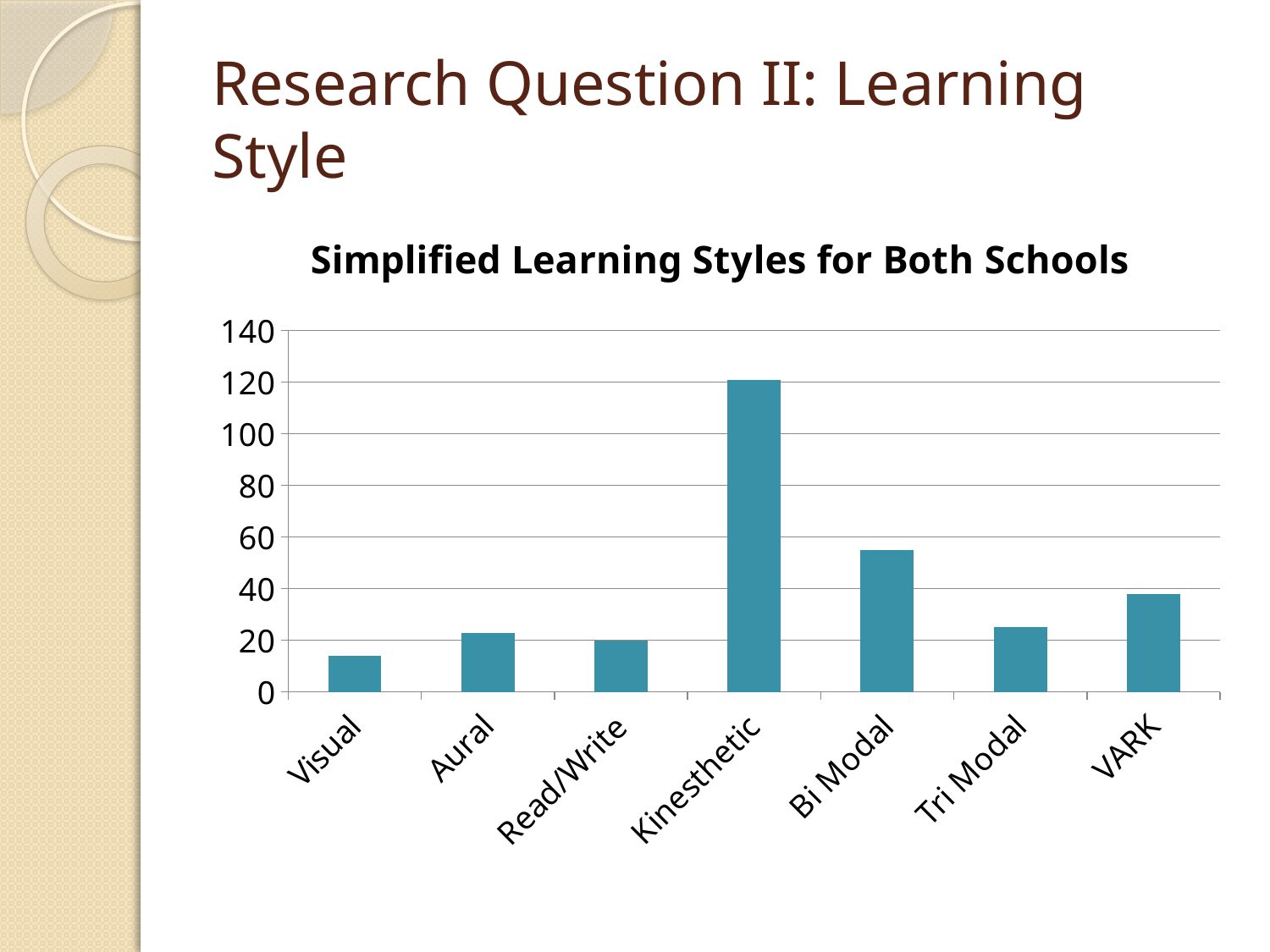
Which is larger, the value for Bi Modal or the value for VARK? Bi Modal Which is larger, the value for Aural or the value for Visual? Aural Which is larger, the value for Kinesthetic or the value for Bi Modal? Kinesthetic What is the title of the chart? Simplified Learning Styles for Both Schools Is the value for Kinesthetic greater or less than 100? greater Which learning style has the highest value? Kinesthetic Is the value for VARK greater or less than 20? greater Is the value for Bi Modal greater or less than 40? greater Which learning style has the lowest value? Visual How many learning style categories are shown on the x axis? 7 What type of chart is shown on the slide? bar chart